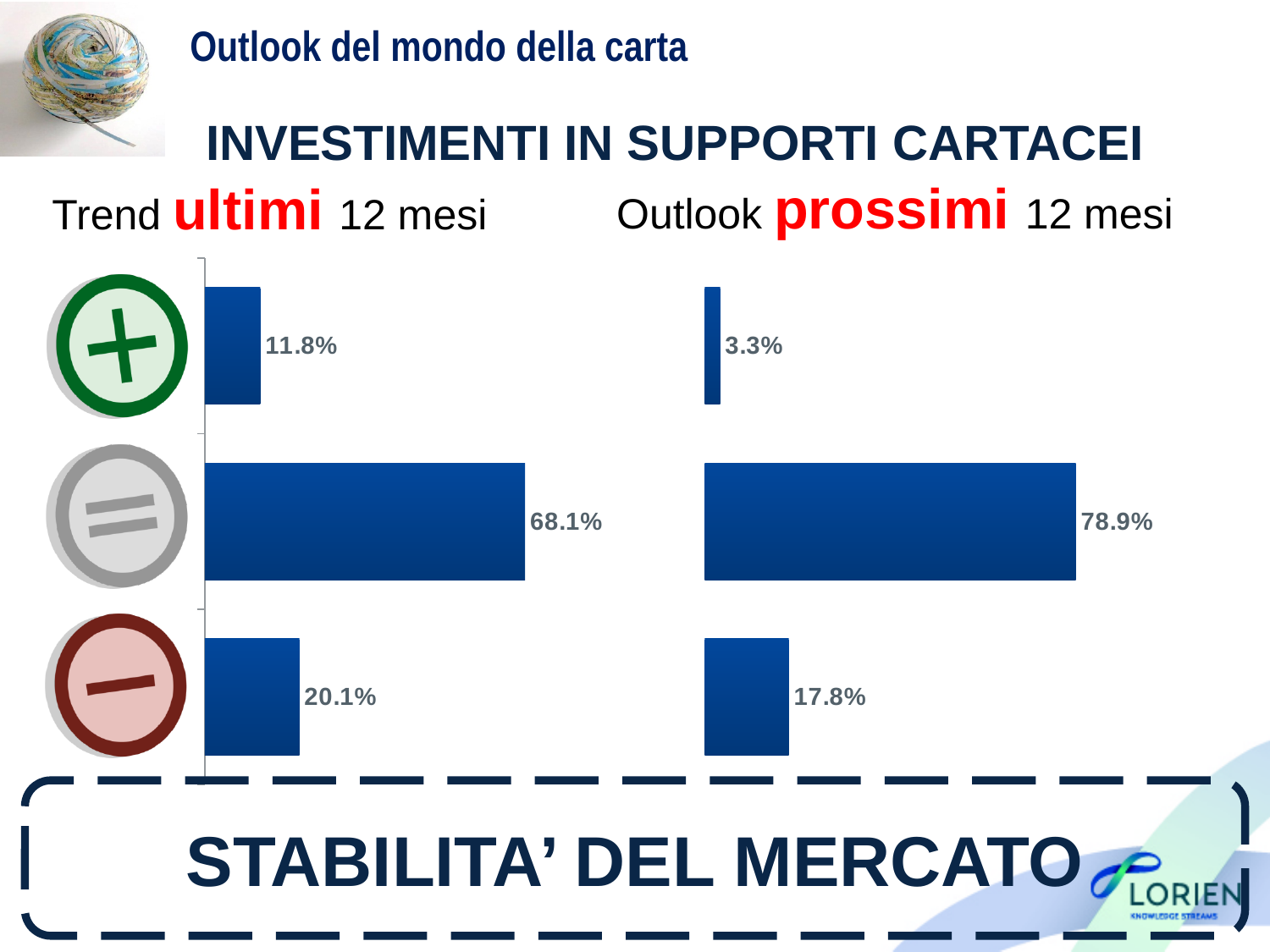
In the 'Outlook prossimi 12 mesi' chart on the right, what is the difference between the '−' value and the '+' value? 14.5% In the 'Trend ultimi 12 mesi' chart on the left, what is the difference between the '=' value and the '−' value? 48.0% What type of chart is the 'Outlook prossimi 12 mesi' chart on the right? Bar chart In the 'Outlook prossimi 12 mesi' chart on the right, what is the value for the '+' (increase) category? 3.3% What is the main title printed above the two charts? INVESTIMENTI IN SUPPORTI CARTACEI In the 'Trend ultimi 12 mesi' chart on the left, what is the value for the '=' (stable) category? 68.1% In the 'Trend ultimi 12 mesi' chart on the left, what is the value for the '−' (decrease) category? 20.1% In the 'Outlook prossimi 12 mesi' chart on the right, what is the value for the '−' (decrease) category? 17.8% In the 'Outlook prossimi 12 mesi' chart on the right, which category has the highest value? = (stable) How many categories are shown in the 'Trend ultimi 12 mesi' chart on the left? 3 In the 'Trend ultimi 12 mesi' chart on the left, which category has the lowest value? + (increase) Which is larger: the '+' value in the 'Trend ultimi 12 mesi' chart or the '+' value in the 'Outlook prossimi 12 mesi' chart? Trend ultimi 12 mesi (11.8%)